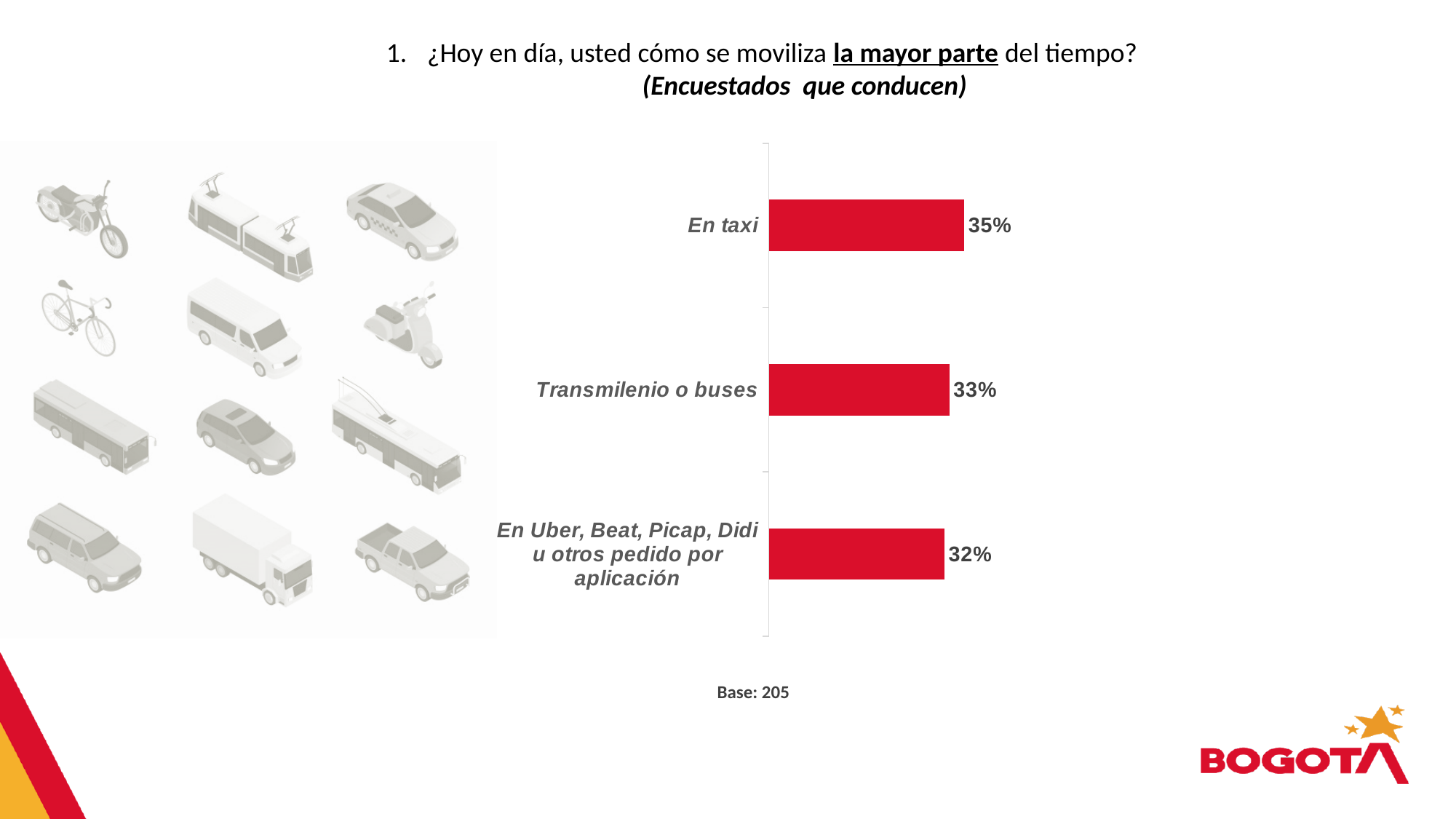
What kind of chart is shown on the slide? Bar chart Which category has the lowest value? En Uber, Beat, Picap, Didi u otros pedido por aplicación What is the difference between the values for "En taxi" and "En Uber, Beat, Picap, Didi u otros pedido por aplicación"? 3% Which is larger, the value for "En taxi" or the value for "En Uber, Beat, Picap, Didi u otros pedido por aplicación"? En taxi What is the value for "En taxi"? 35% How many categories are shown in the chart? 3 Which category has the highest value? En taxi What is the value for "En Uber, Beat, Picap, Didi u otros pedido por aplicación"? 32% What is the difference between the values for "En taxi" and "Transmilenio o buses"? 2% What is the base (number of respondents) stated below the chart? 205 What colour are the bars in the chart? Red What is the value for "Transmilenio o buses"? 33%